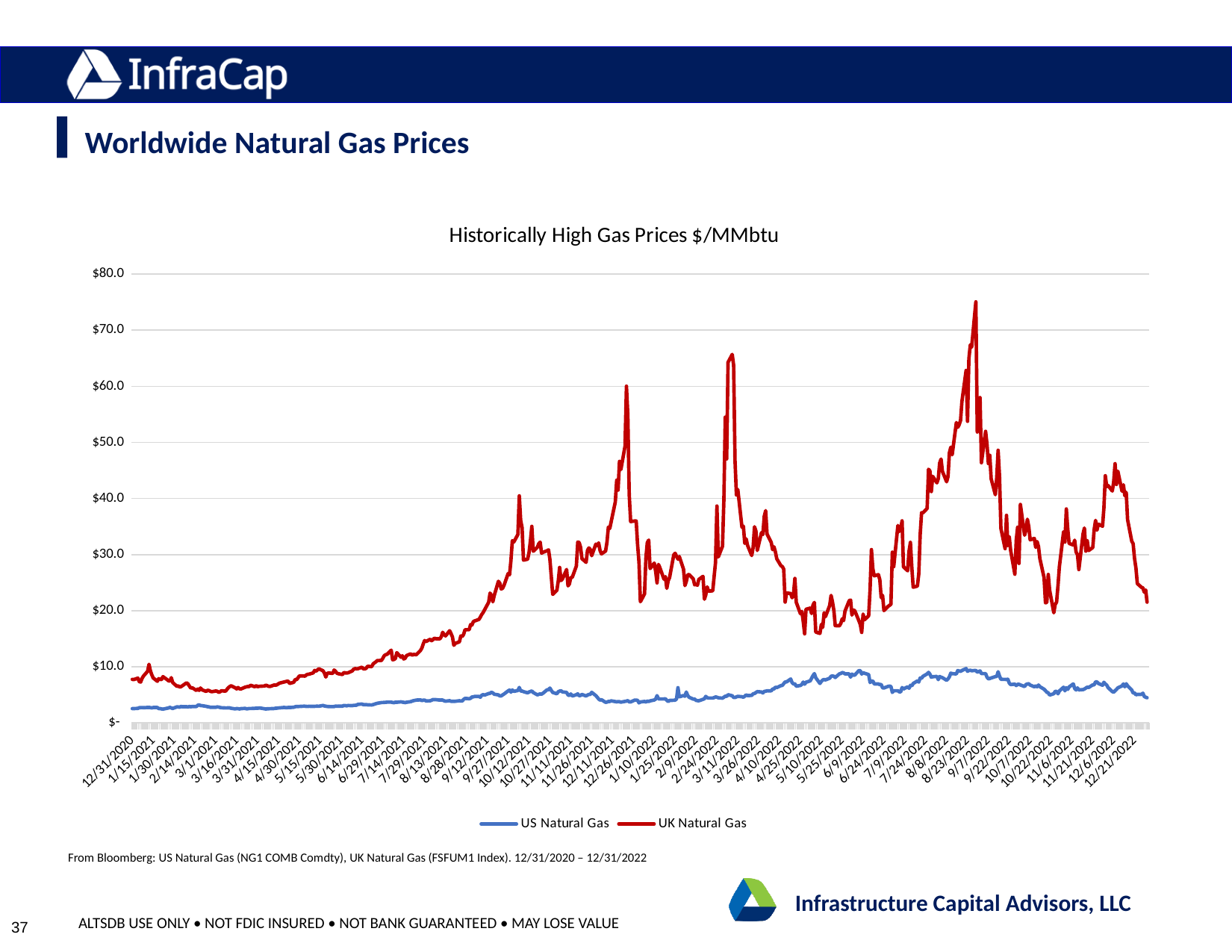
Which series is higher at the end of the period, US Natural Gas or UK Natural Gas? UK Natural Gas Is the highest value of UK Natural Gas around 12/26/2021 greater or less than $50.0? greater How many series does the legend list? 2 What is the highest value shown on the y axis? $80.0 What is the title of the chart? Historically High Gas Prices $/MMbtu What kind of chart is shown on the slide? Line chart Which series reaches the higher peak value, US Natural Gas or UK Natural Gas? UK Natural Gas Is the value for UK Natural Gas at the end of the period (late December 2022) greater or less than $30.0? less Is the peak value of UK Natural Gas greater or less than $70.0? greater Which colour is used for the UK Natural Gas line? Red Does the UK Natural Gas line rise or fall between 12/31/2020 and 9/27/2021? rise